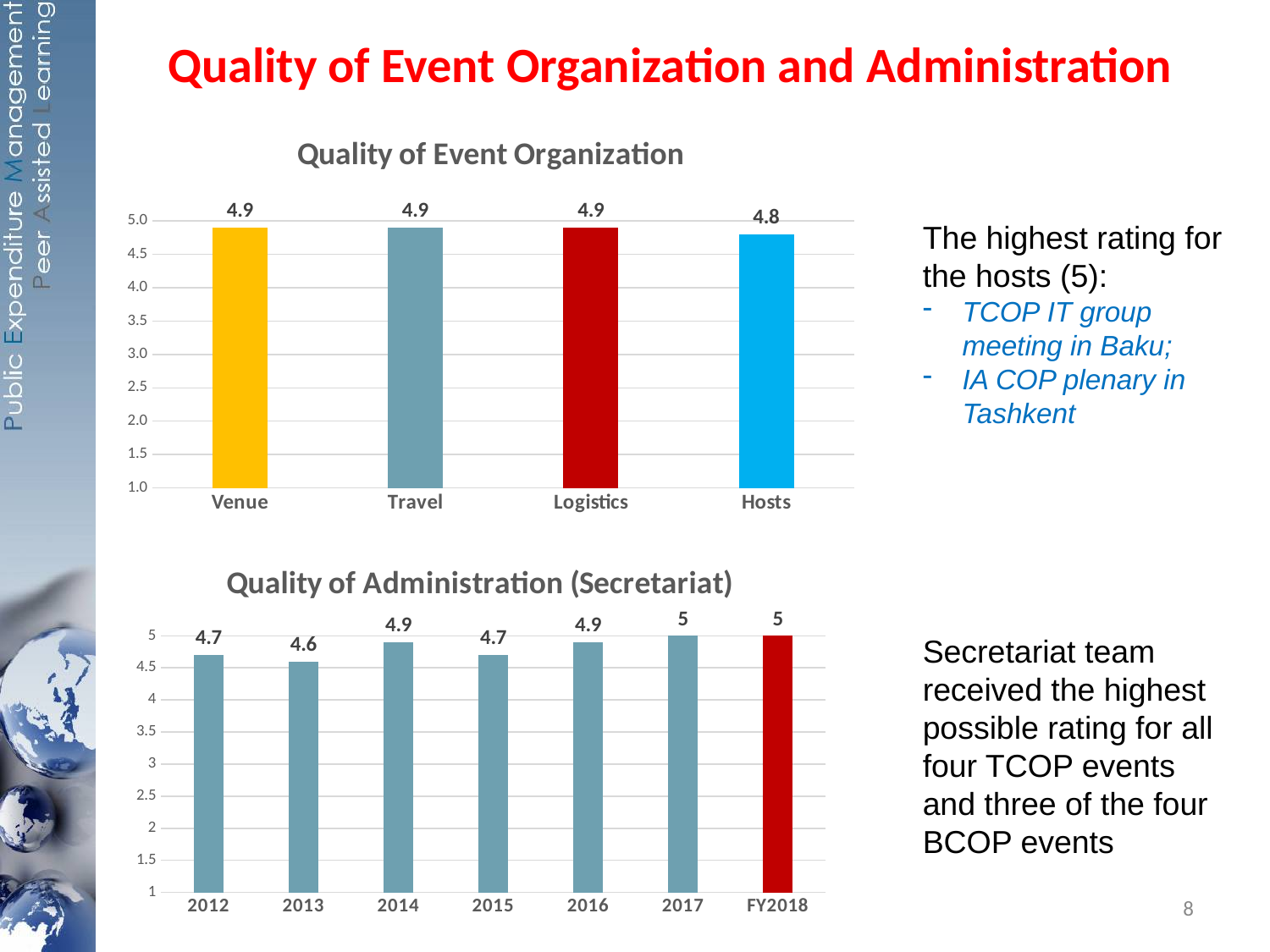
In the 'Quality of Event Organization' chart, what is the difference between the values for Venue and Hosts? 0.1 In the 'Quality of Administration (Secretariat)' chart, what colour is the bar for FY2018? Red In the 'Quality of Event Organization' chart, how many categories are shown? 4 In the 'Quality of Administration (Secretariat)' chart, which year has the lowest value? 2013 In the 'Quality of Administration (Secretariat)' chart, which is larger, the value for 2014 or the value for 2015? 2014 In the 'Quality of Event Organization' chart, what is the value for Hosts? 4.8 What kind of chart is the 'Quality of Event Organization' chart? Bar chart In the 'Quality of Event Organization' chart, which category has the lowest value? Hosts In the 'Quality of Administration (Secretariat)' chart, how many years are shown? 7 In the 'Quality of Administration (Secretariat)' chart, what is the difference between the values for 2017 and 2013? 0.4 In the 'Quality of Administration (Secretariat)' chart, what is the value for 2013? 4.6 In the 'Quality of Administration (Secretariat)' chart, what is the value for FY2018? 5